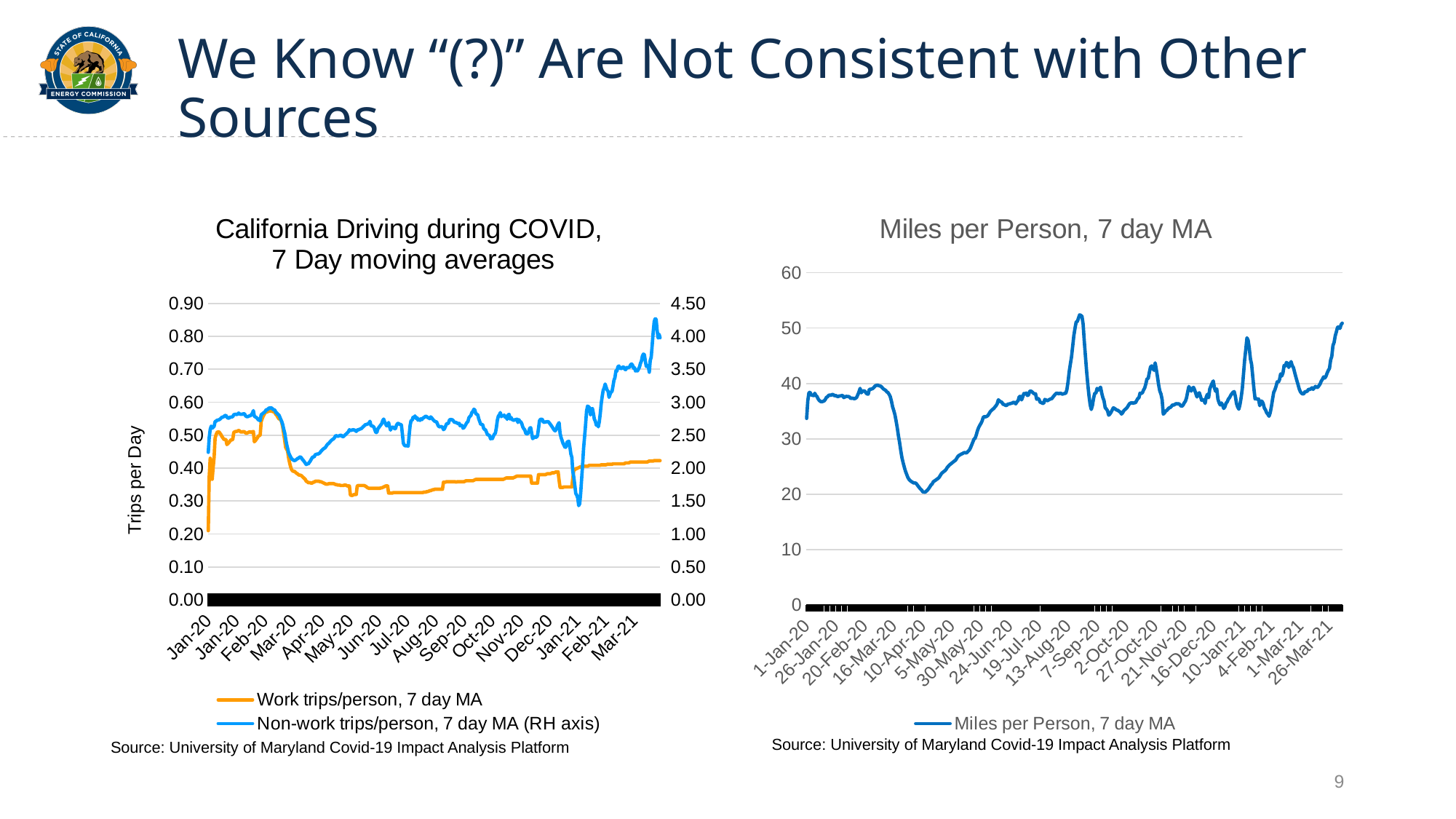
In the right chart (Miles per Person, 7 day MA), do the values rise or fall between 16-Mar-20 and 10-Apr-20? fall What kind of chart is the right chart titled "Miles per Person, 7 day MA"? Line chart How many series does the legend of the left chart (California Driving during COVID) list? 2 In the left chart (California Driving during COVID), which series is plotted on the right-hand axis? Non-work trips/person, 7 day MA In the right chart (Miles per Person, 7 day MA), is the value at 26-Mar-21 greater or less than 40? greater How many series does the legend of the right chart (Miles per Person, 7 day MA) list? 1 In the right chart (Miles per Person, 7 day MA), is the value around 10-Apr-20 greater or less than 30? less In the left chart (California Driving during COVID), is the value for Work trips/person in Jul-20 greater or less than 0.40? less What kind of chart is the left chart titled "California Driving during COVID, 7 Day moving averages"? Line chart What is the label on the vertical axis of the left chart (California Driving during COVID)? Trips per Day In the left chart (California Driving during COVID), is the value for Work trips/person higher in Jan-20 or in Mar-21? Jan-20